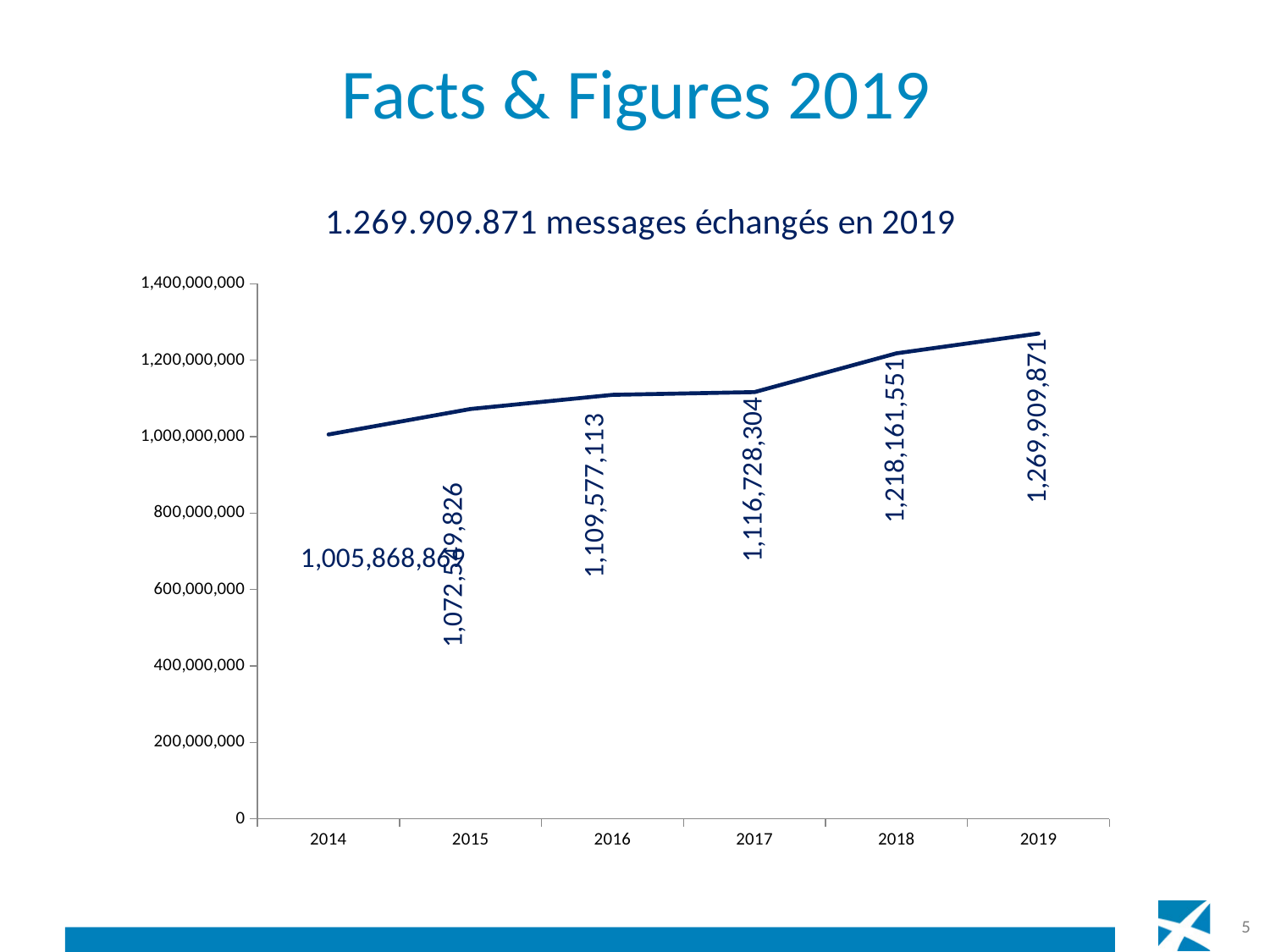
What is the value plotted for 2019? 1,269,909,871 What is the value plotted for 2018? 1,218,161,551 Is the value for 2014 greater or less than 1,200,000,000? less What is the difference between the values for 2019 and 2018? 51,748,320 What is the value plotted for 2016? 1,109,577,113 What is the value plotted for 2017? 1,116,728,304 How many years are plotted on the chart? 6 What is the difference between the values for 2018 and 2017? 101,433,247 Which year has the lowest value on the chart? 2014 Is the value for 2015 greater or less than 1,000,000,000? greater Which year has the highest value on the chart? 2019 What kind of chart is shown on the slide? line chart